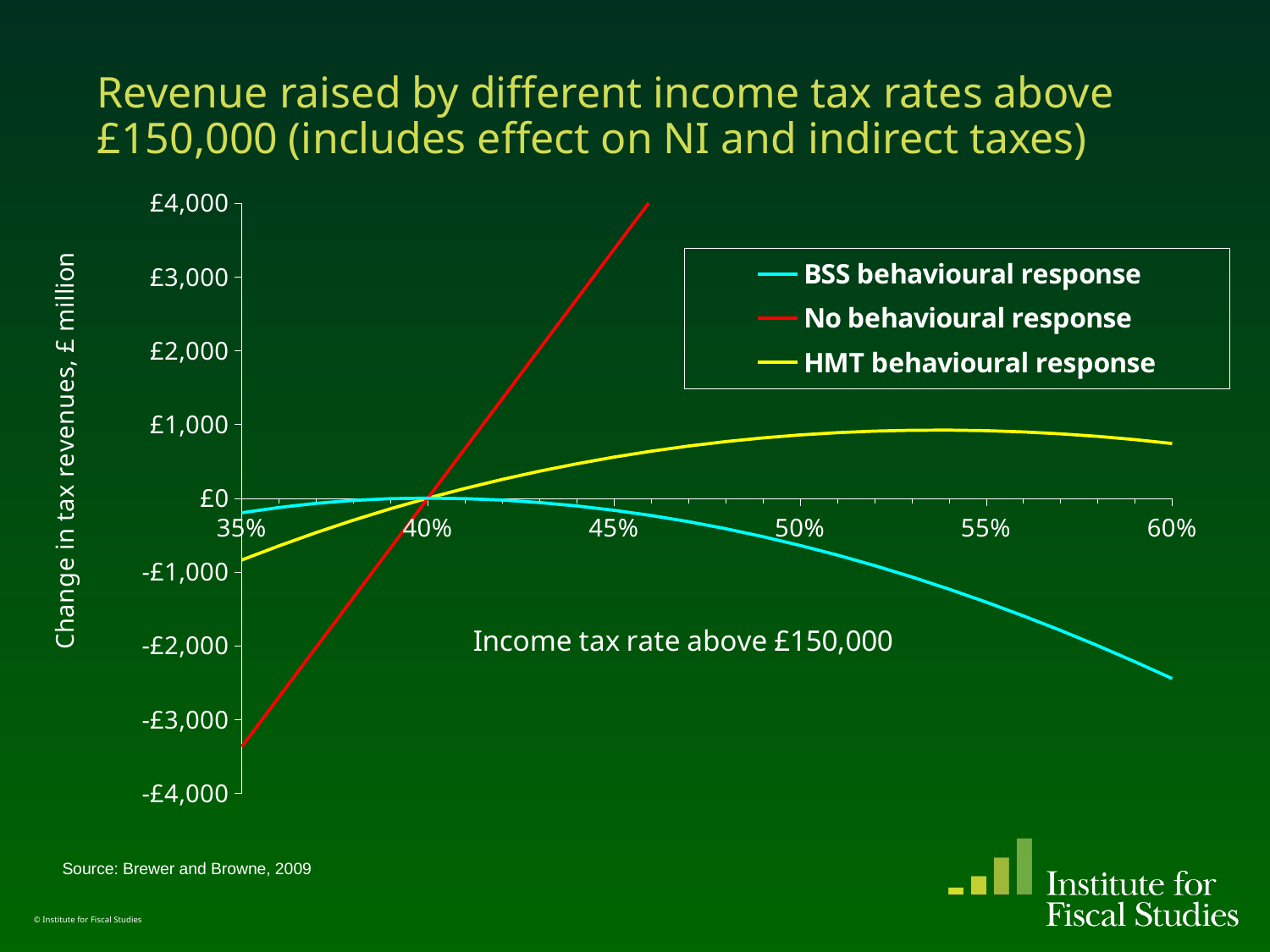
Does the No behavioural response line rise or fall as the income tax rate increases from 35% to 45%? Rises Is the value for the HMT behavioural response line at 35% greater or less than £0? less How many series does the legend list? 3 At 60%, which line has the larger value: HMT behavioural response or BSS behavioural response? HMT behavioural response Which series has the highest value at an income tax rate of 45%? No behavioural response Which series is drawn in red? No behavioural response What is the label on the vertical axis? Change in tax revenues, £ million Is the value for the HMT behavioural response line at 60% greater or less than £1,000? less Is the value for the No behavioural response line at 45% greater or less than £3,000? greater What kind of chart is shown on the slide? Line chart